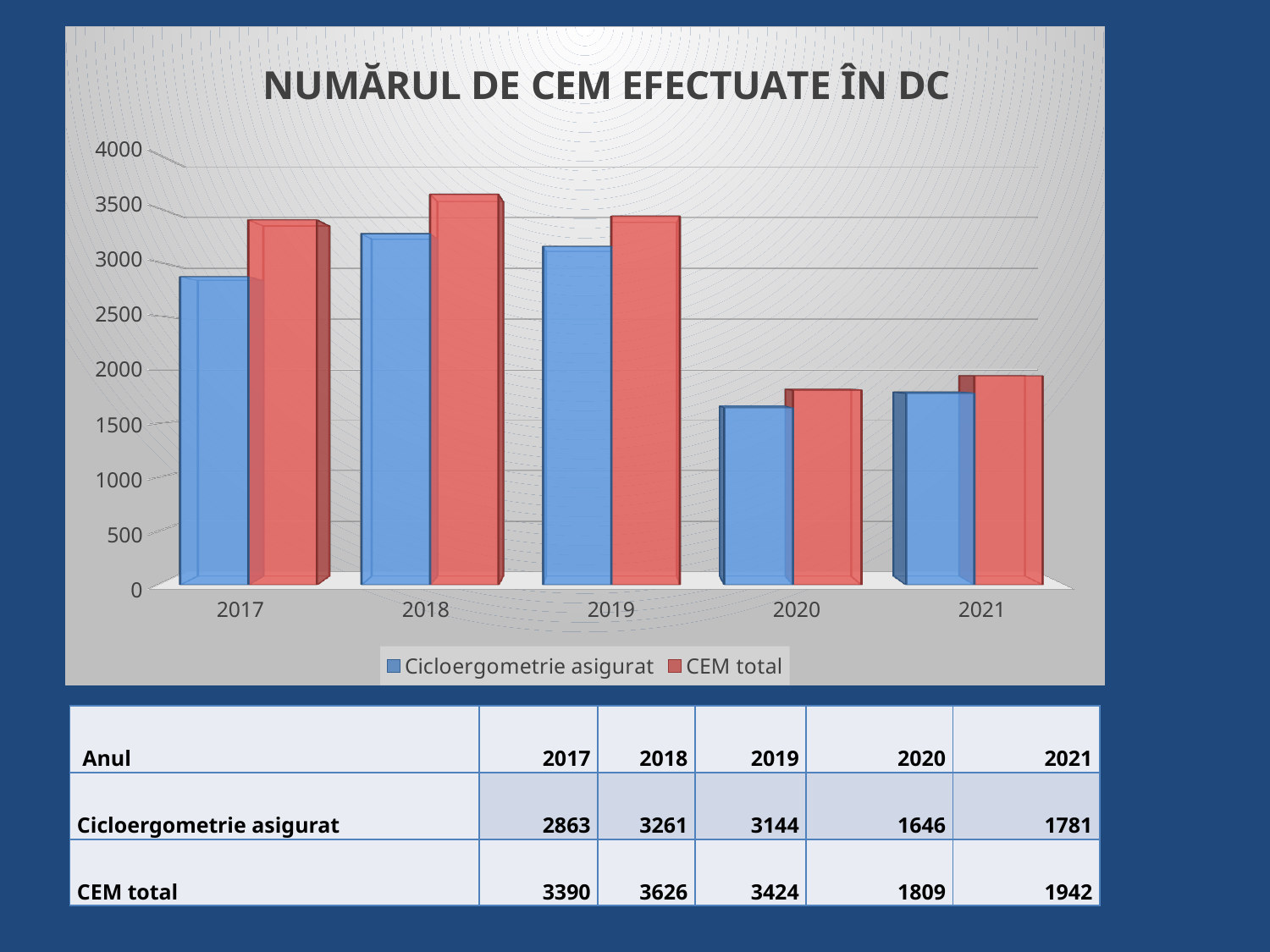
What is the title of the chart? NUMĂRUL DE CEM EFECTUATE ÎN DC Is the CEM total for 2020 greater or less than 2000? less Does the CEM total rise or fall from 2019 to 2020? fall How many series does the chart legend list? 2 What is the difference between CEM total and Cicloergometrie asigurat in 2017? 527 Which is larger, Cicloergometrie asigurat in 2019 or in 2021? 2019 What is the value of Cicloergometrie asigurat for 2020? 1646 How many years are shown on the x axis of the chart? 5 What is the value of CEM total for 2018? 3626 Which year has the lowest Cicloergometrie asigurat value? 2020 What kind of chart is shown on the slide? bar chart Which year has the highest CEM total? 2018